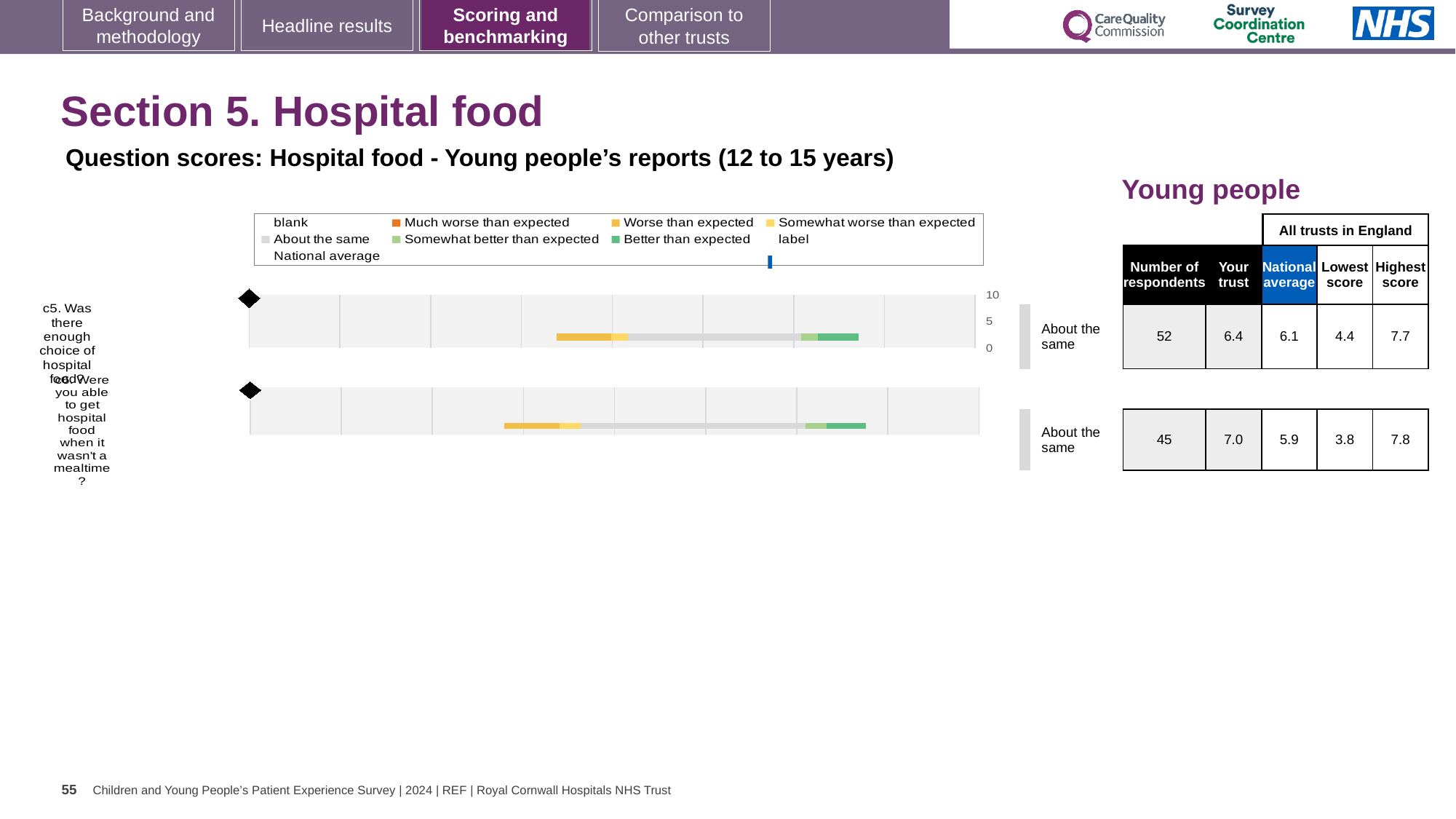
What is the number of respondents for question c6? 45 What kind of chart is used to show the question scores for hospital food? bar chart What is the 'Your trust' score for question c5 (Was there enough choice of hospital food?)? 6.4 What is the highest score across all trusts in England for question c6? 7.8 What is the 'Your trust' score for question c6 (Were you able to get hospital food when it wasn't a mealtime?)? 7.0 Which question has the higher 'Your trust' score, c5 or c6? c6 What benchmark rating is given to the trust for question c5? About the same Which legend entry is shown in dark green in the hospital food chart? Better than expected How many survey questions (categories) are plotted in the hospital food chart? 2 What is the difference between the 'Your trust' score and the national average for question c6? 1.1 What is the national average score for question c5? 6.1 What is the highest value shown on the chart's axis? 10